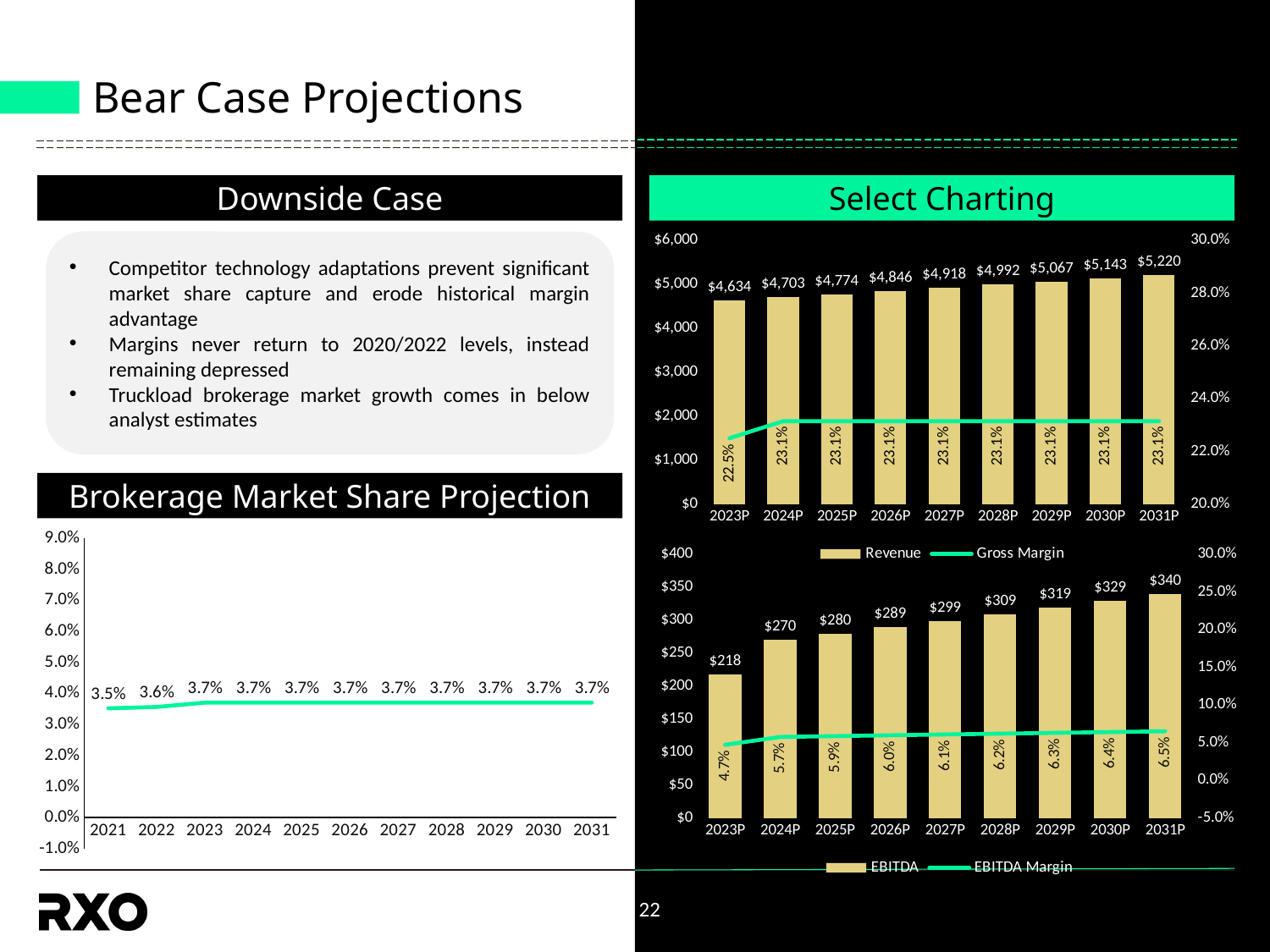
In the bottom-right EBITDA chart, what is the EBITDA Margin for 2031P? 6.5% In the top-right Revenue chart, what is the difference in Revenue between 2031P and 2023P? $586 In the Brokerage Market Share Projection chart, what is the value for 2023? 3.7% How many years are plotted on the x axis of the Brokerage Market Share Projection chart? 11 In the top-right Revenue chart, what is the Revenue value for 2023P? $4,634 In the Brokerage Market Share Projection chart, what is the value for 2021? 3.5% In the top-right Revenue chart, which year has the highest Revenue? 2031P In the top-right Revenue chart, what is the Gross Margin for 2023P? 22.5% In the bottom-right EBITDA chart, what is the EBITDA value for 2026P? $289 What kind of chart is the Brokerage Market Share Projection chart? Line chart In the bottom-right EBITDA chart, does EBITDA rise or fall from 2023P to 2031P? Rise How many series does the legend of the top-right Revenue chart list? 2